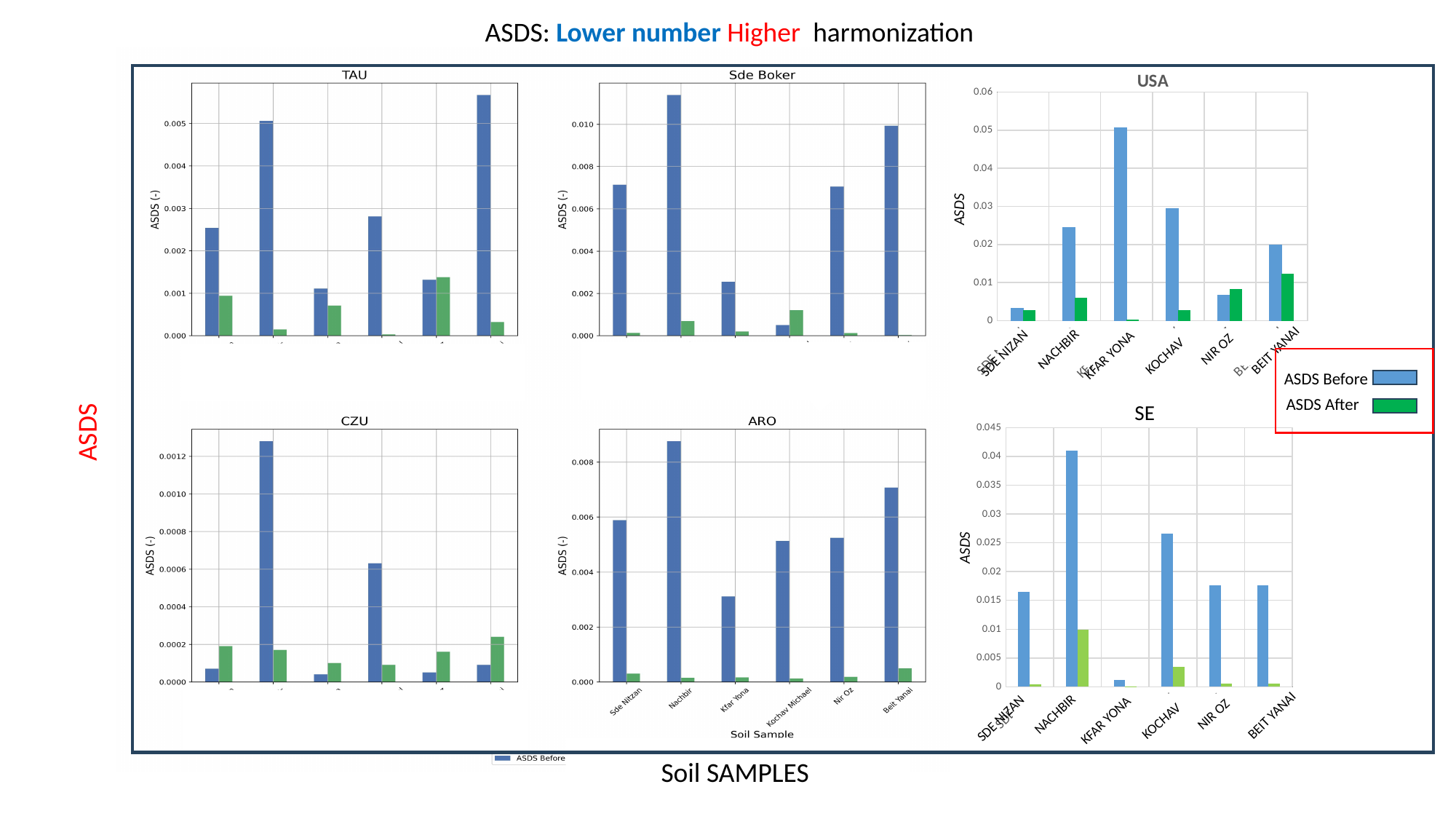
In the USA chart, which soil sample has the highest ASDS Before value? KFAR YONA In the SE chart, is the ASDS Before value for NACHBIR greater or less than 0.035? greater How many soil samples are shown on the x axis of the SE chart? 6 In the ARO chart, which soil sample has the highest ASDS Before value? Nachbir What kind of chart is the USA chart? bar chart In the USA chart, which is larger, the ASDS Before value for KOCHAV or for NIR OZ? KOCHAV In the SE chart, which soil sample has the lowest ASDS Before value? KFAR YONA How many series does the legend in the red box list? 2 How many charts are shown on the slide? 6 In the SE chart, which soil sample has the highest ASDS Before value? NACHBIR In the ARO chart, which soil sample has the lowest ASDS Before value? Kfar Yona In the USA chart, is the ASDS Before value for KFAR YONA greater or less than 0.04? greater